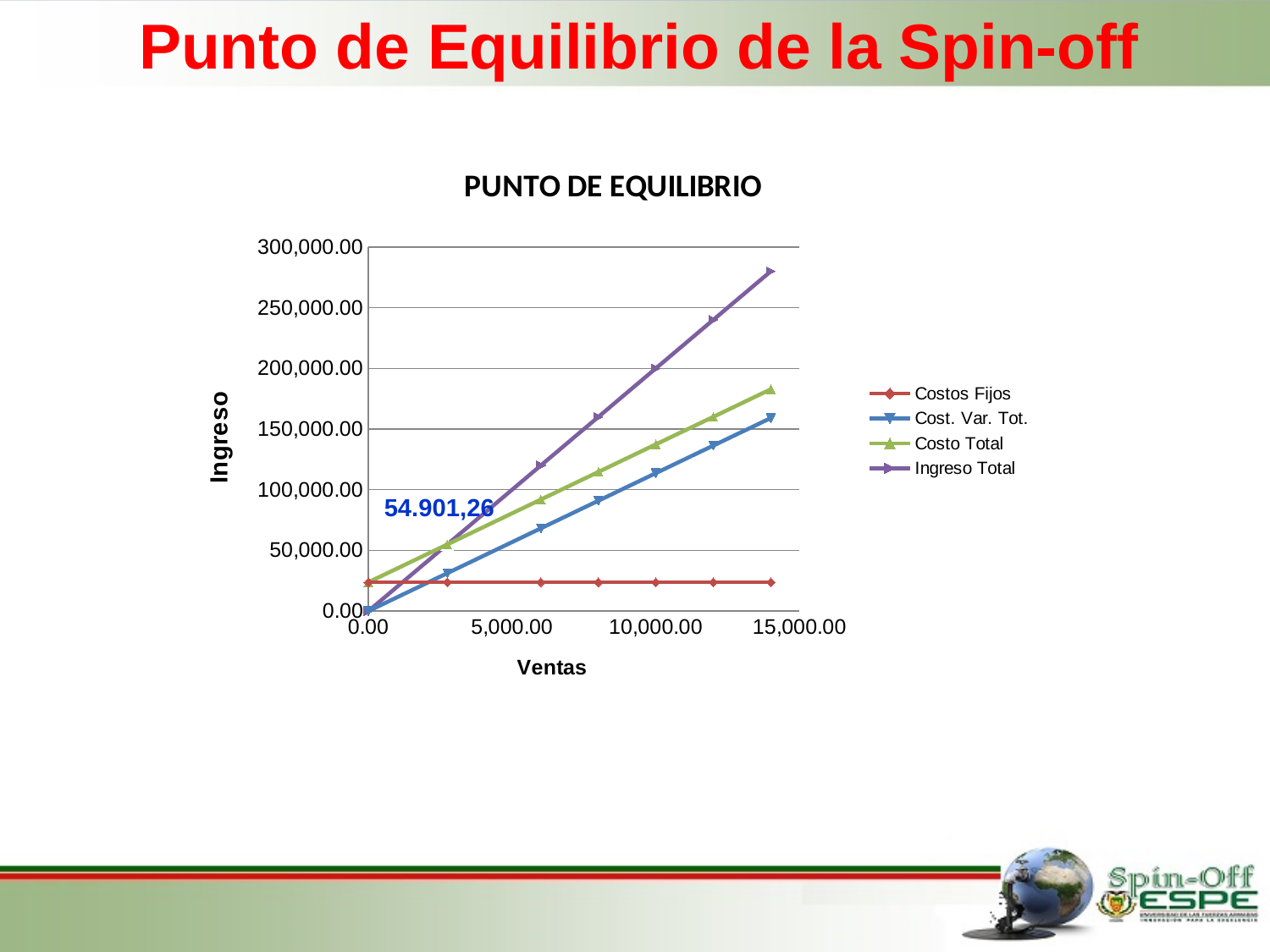
Does the Ingreso Total line rise or fall as Ventas increases? rises Is the value of Costos Fijos greater or less than 50,000.00? less What value is annotated in blue on the chart near the point where the lines cross? 54.901,26 How many series does the legend of the chart list? 4 How many data points are plotted for the Ingreso Total series? 7 Which series reaches the highest value at the right end of the chart? Ingreso Total Does the Costos Fijos line rise, fall or stay flat as Ventas increases? stays flat What type of chart is shown on the slide? line chart Is the highest value of Ingreso Total greater or less than 250,000.00? greater Which series has the lowest value at the right end of the chart? Costos Fijos At the right end of the chart, which is larger: Costo Total or Cost. Var. Tot.? Costo Total What is the title of the chart? PUNTO DE EQUILIBRIO